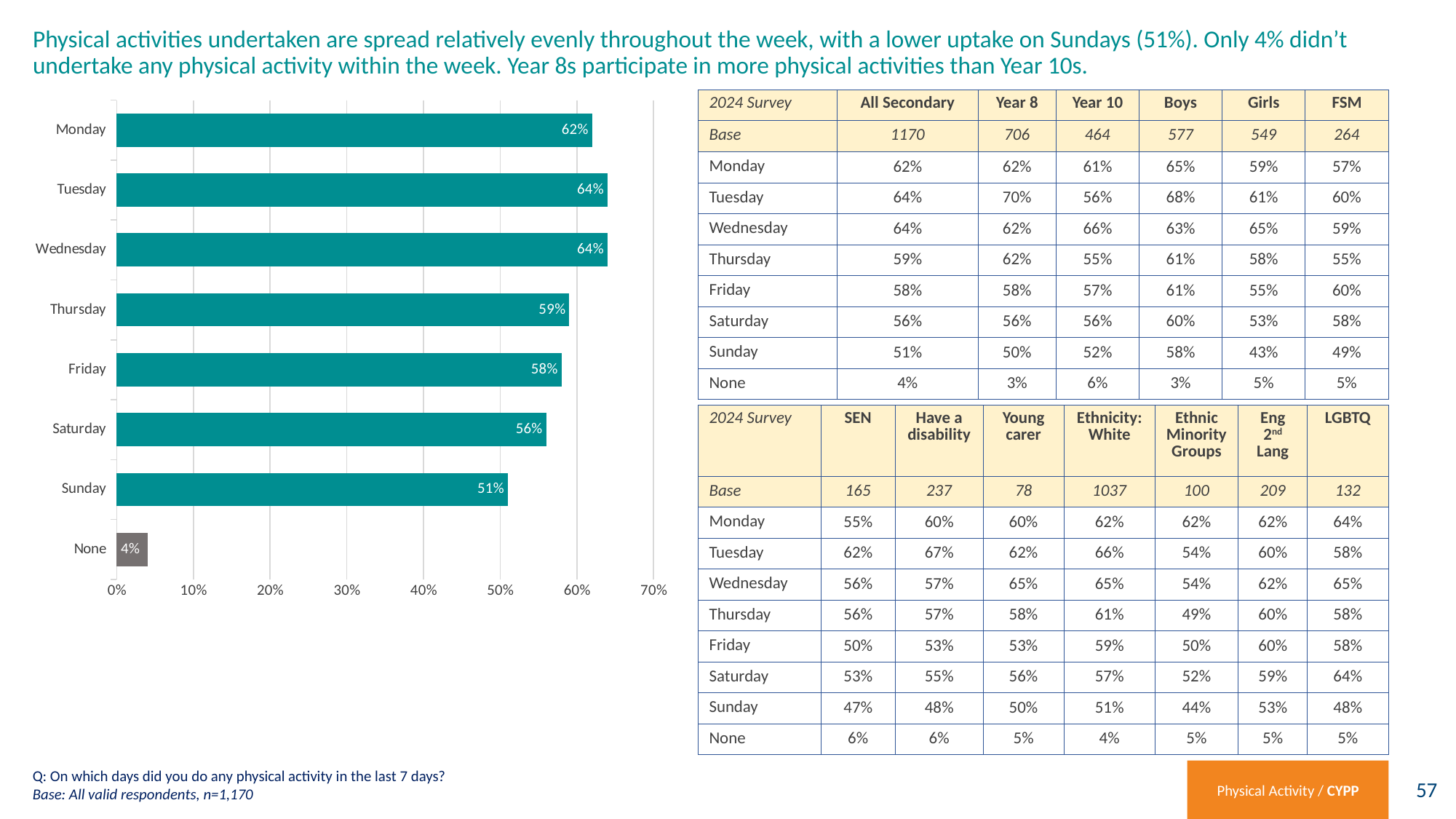
Which is larger in the bar chart, the value for Thursday or the value for Saturday? Thursday Which category has the lowest value in the bar chart? None Which day of the week has the lowest value in the bar chart? Sunday What is the value for None in the bar chart? 4% What is the value for Monday in the bar chart? 62% What is the highest value shown on the x axis of the bar chart? 70% What is the value for Sunday in the bar chart? 51% How many categories are shown in the bar chart? 8 What is the difference between the values for Tuesday and Sunday in the bar chart? 13% What kind of chart is shown on the slide? bar chart Is the value for Friday in the bar chart greater or less than 50%? greater What is the value for Wednesday in the bar chart? 64%